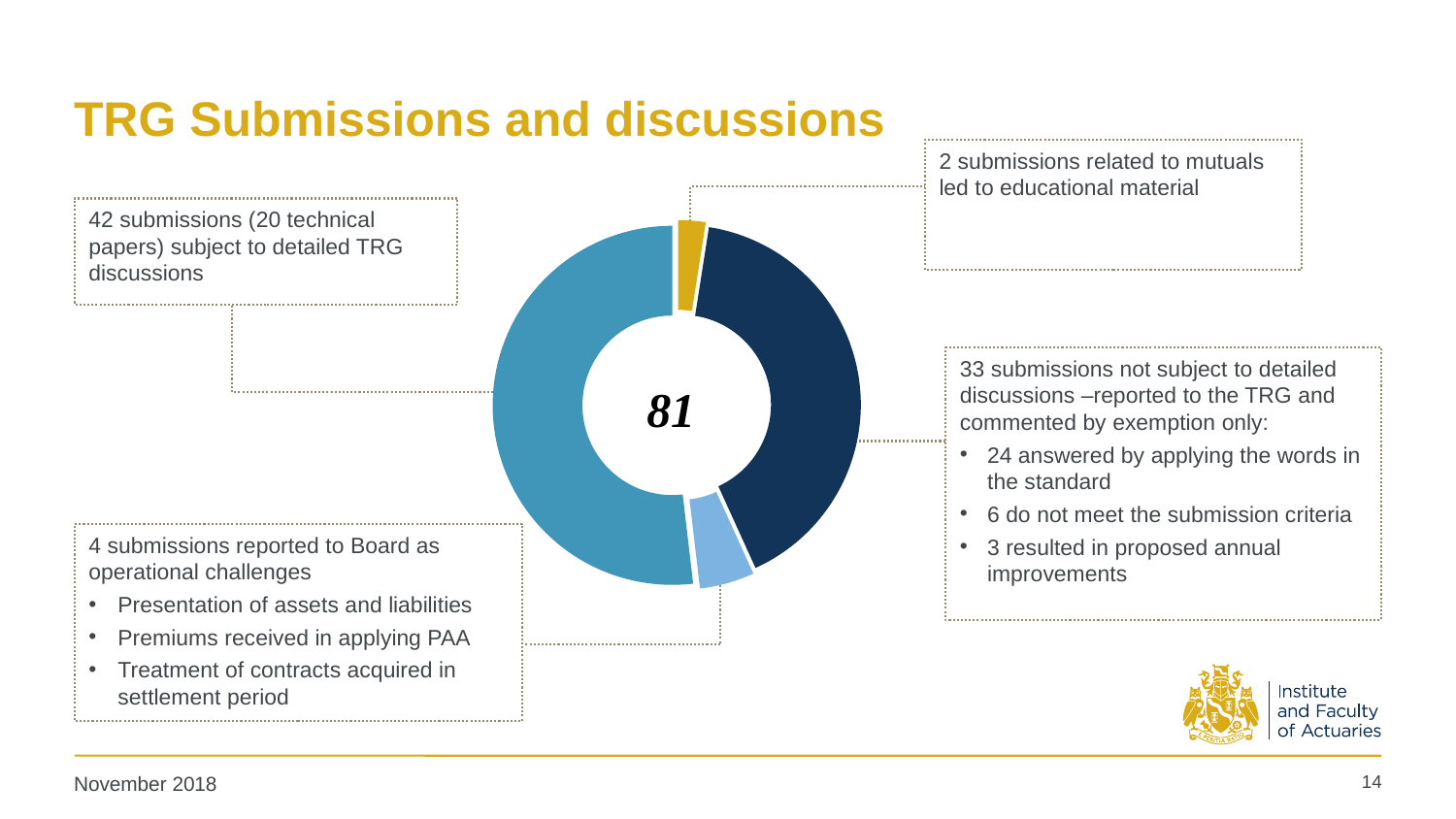
How many submissions were not subject to detailed discussions? 33 How many submissions were subject to detailed TRG discussions? 42 What colour is the segment representing the 2 submissions related to mutuals? Gold Which category accounts for the smallest segment of the doughnut chart? 2 submissions related to mutuals What number is printed in the centre of the doughnut chart? 81 What is the difference between the number of submissions subject to detailed TRG discussions and the number not subject to detailed discussions? 9 What kind of chart is shown on the slide? Doughnut chart How many submissions related to mutuals led to educational material? 2 How many submissions were reported to the Board as operational challenges? 4 How many segments does the doughnut chart have? 4 Which category accounts for the largest segment of the doughnut chart? 42 submissions subject to detailed TRG discussions Which is larger: the number of submissions reported to the Board as operational challenges or the number related to mutuals? Submissions reported to the Board as operational challenges